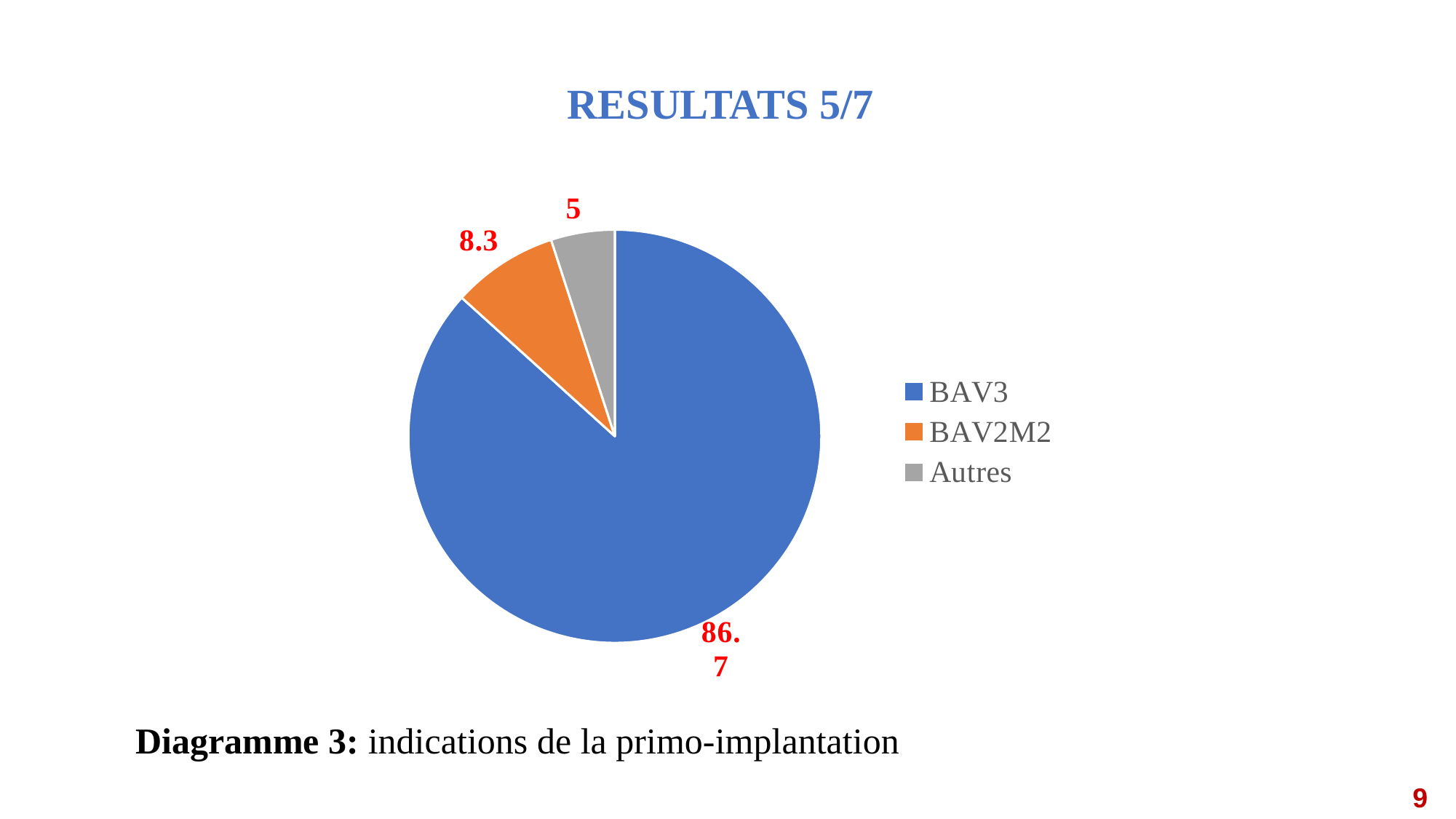
What kind of chart is shown on the slide? Pie chart What is the difference between the values for BAV3 and BAV2M2? 78.4 What is the value shown for BAV2M2? 8.3 What is the value shown for BAV3? 86.7 What colour is the slice for BAV2M2? Orange What is the caption of the diagram below the chart? Diagramme 3: indications de la primo-implantation How many categories are shown in the pie chart? 3 What is the value shown for Autres? 5 Which category has the largest slice of the pie? BAV3 Which category has the smallest slice of the pie? Autres What is the difference between the values for BAV2M2 and Autres? 3.3 Which is larger, the value for BAV2M2 or the value for Autres? BAV2M2